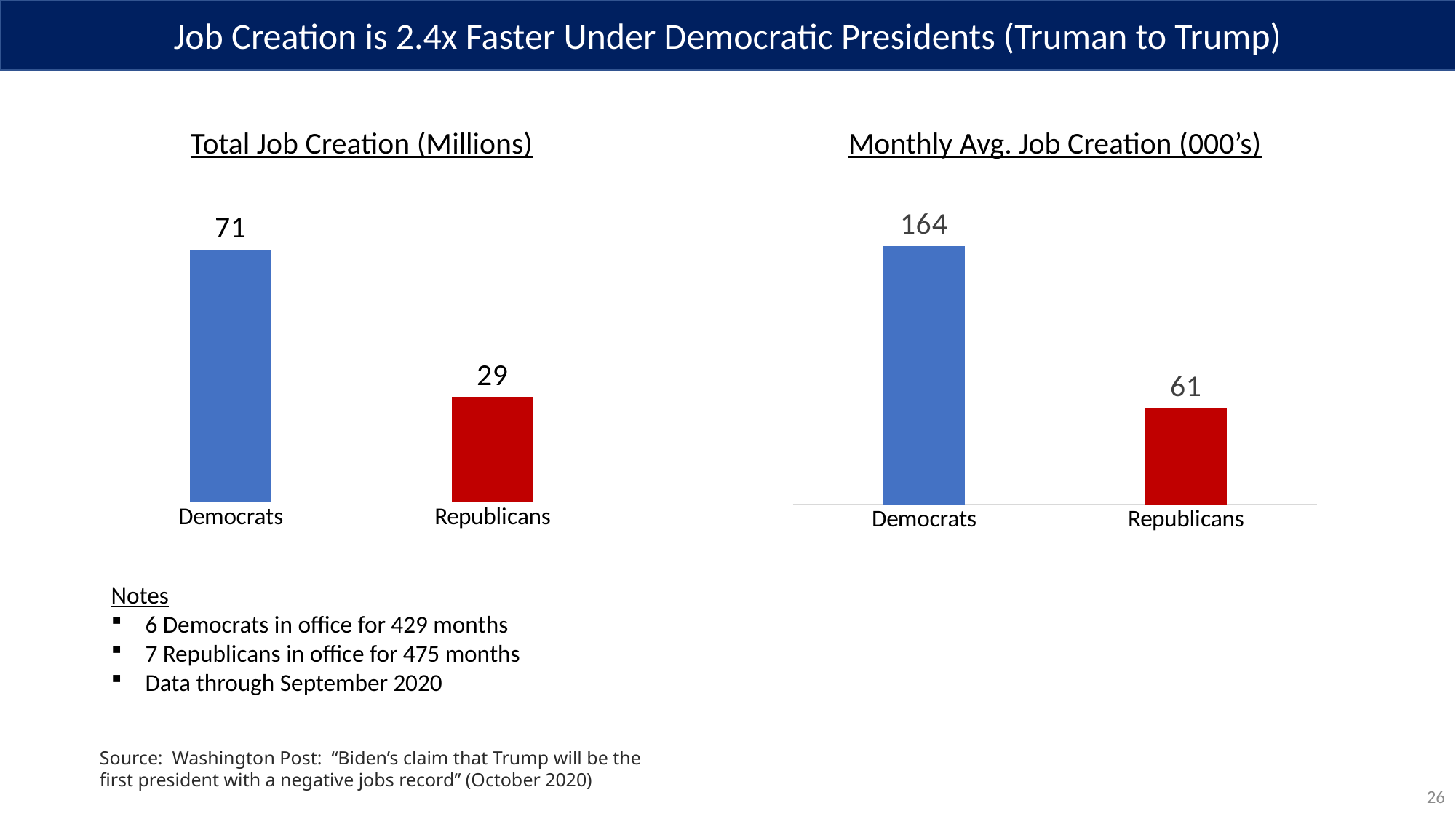
In the Monthly Avg. Job Creation (000's) chart, which category has the lowest value? Republicans In the Monthly Avg. Job Creation (000's) chart, what is the value for Republicans? 61 In the Total Job Creation (Millions) chart, what is the value for Republicans? 29 What kind of chart is the Monthly Avg. Job Creation (000's) chart? Bar chart In the Monthly Avg. Job Creation (000's) chart, what is the value for Democrats? 164 In the Total Job Creation (Millions) chart, what colour is the Republicans bar? Red In the Total Job Creation (Millions) chart, what is the value for Democrats? 71 In the Monthly Avg. Job Creation (000's) chart, what is the difference between the Democrats and Republicans values? 103 In the Total Job Creation (Millions) chart, which category has the highest value? Democrats In the Total Job Creation (Millions) chart, what is the difference between the Democrats and Republicans values? 42 In the Monthly Avg. Job Creation (000's) chart, which is larger, the value for Democrats or the value for Republicans? Democrats How many categories are shown in the Total Job Creation (Millions) chart? 2